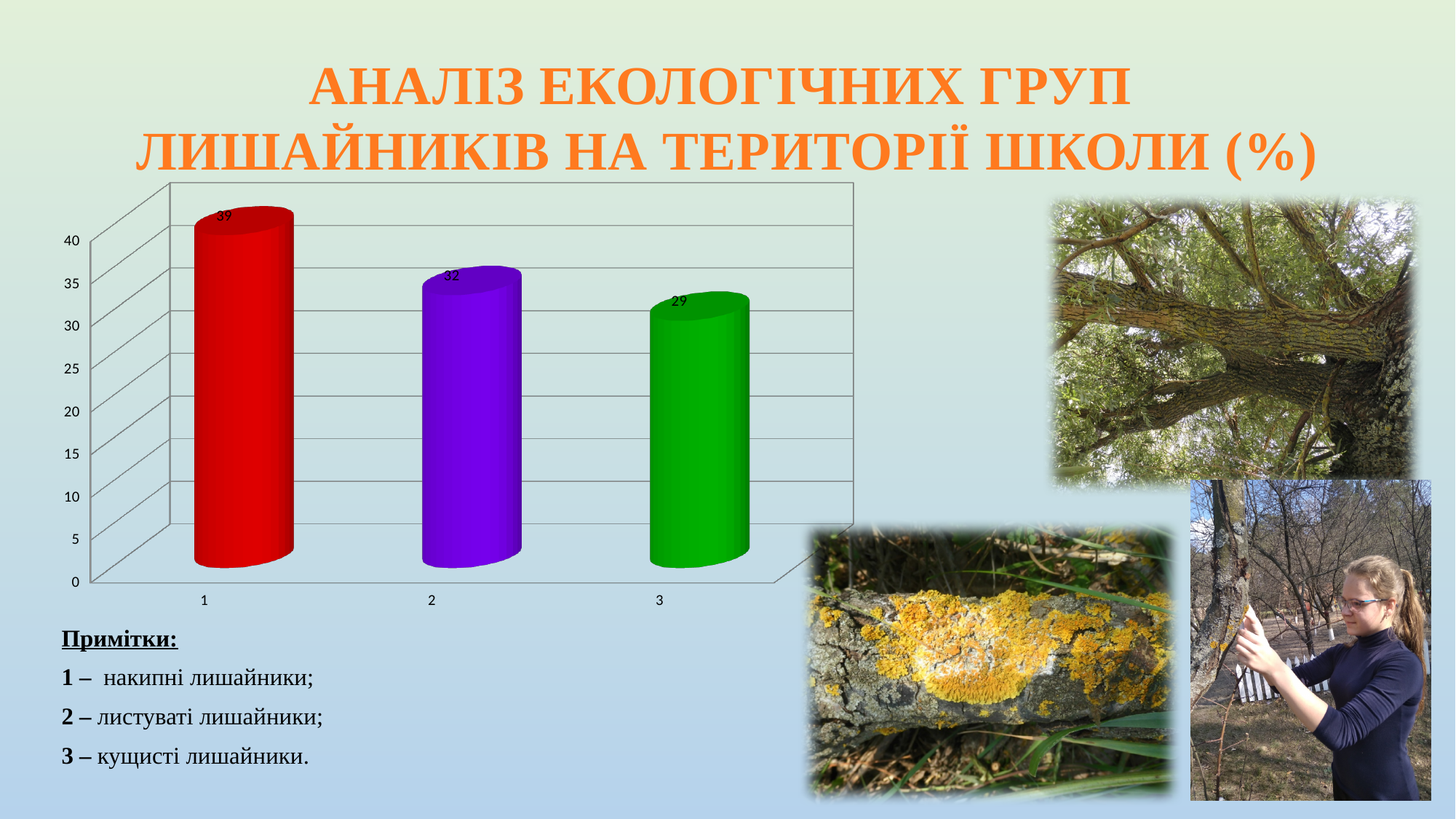
What is the value for category 2? 32 How many categories are shown in the chart? 3 Which category has the highest value? 1 Is the value for category 3 greater or less than 30? less Which is larger, the value for category 1 or category 2? 1 What is the difference between the values for category 2 and category 3? 3 What is the value for category 3? 29 Which category has the lowest value? 3 What is the difference between the values for category 1 and category 3? 10 What kind of chart is shown on the slide? bar chart What is the value for category 1? 39 Do the values rise or fall from category 1 to category 3? fall